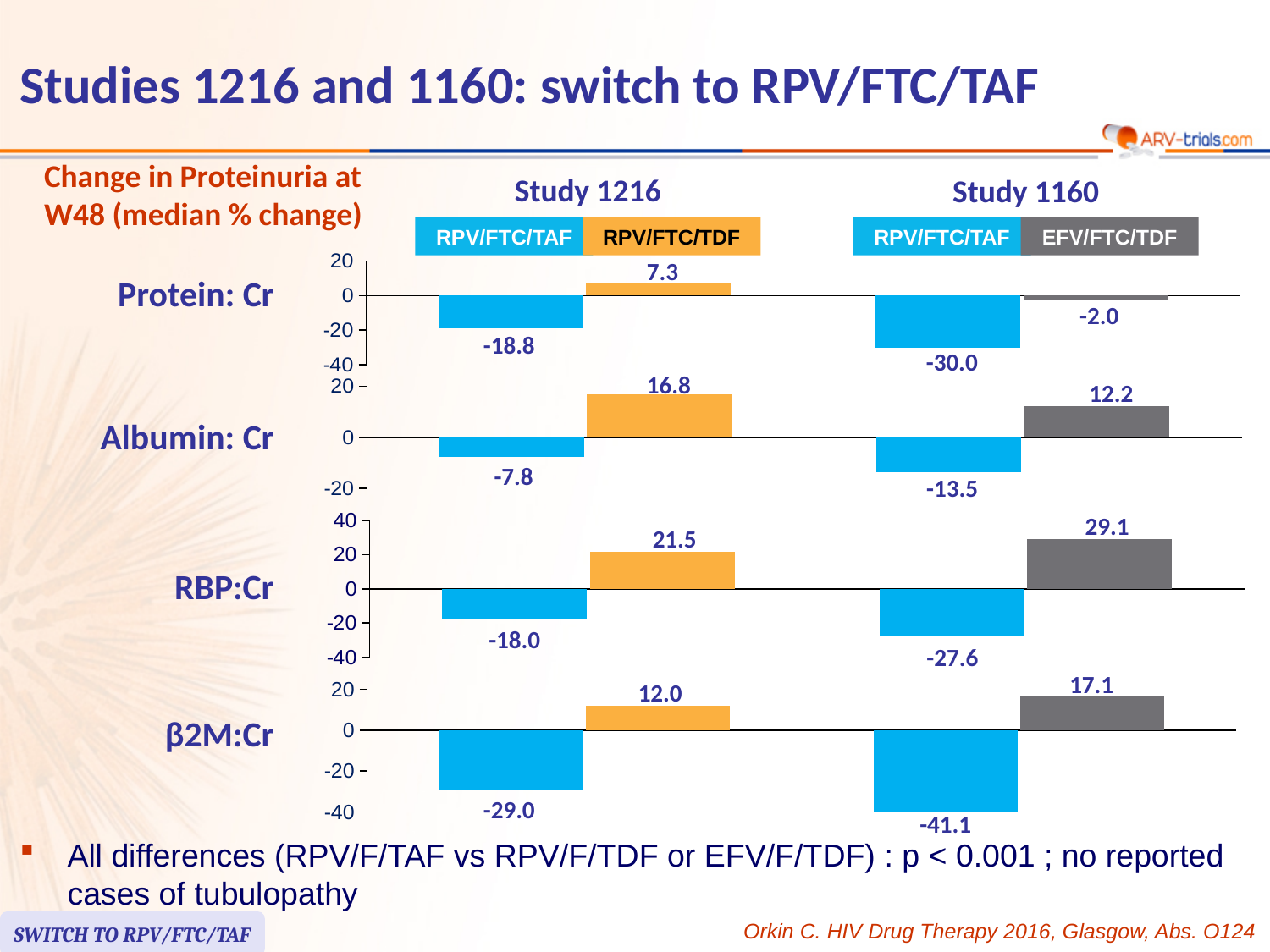
Which colour represents the RPV/FTC/TAF arm in the charts? Blue What type of chart is used to show the change in proteinuria on this slide? Bar chart In the RBP:Cr charts, which is larger: the RPV/FTC/TDF value in Study 1216 or the EFV/FTC/TDF value in Study 1160? EFV/FTC/TDF in Study 1160 (29.1) In the Protein: Cr chart for Study 1160, what is the median % change for EFV/FTC/TDF? -2.0 In the Albumin: Cr chart for Study 1216, what is the value for RPV/FTC/TDF? 16.8 Across all the charts, which arm and marker shows the lowest (most negative) median % change? RPV/FTC/TAF, β2M:Cr (Study 1160), -41.1 In the Protein: Cr chart for Study 1160, what is the difference between the EFV/FTC/TDF value (-2.0) and the RPV/FTC/TAF value (-30.0)? 28.0 In the β2M:Cr chart for Study 1160, what is the value for EFV/FTC/TDF? 17.1 In the β2M:Cr chart for Study 1216, what is the difference between the RPV/FTC/TDF value (12.0) and the RPV/FTC/TAF value (-29.0)? 41.0 How many proteinuria markers (chart rows) are shown on the slide? 4 In the Protein: Cr chart for Study 1216, what is the median % change for RPV/FTC/TAF? -18.8 In the RBP:Cr chart for Study 1160, what is the value for RPV/FTC/TAF? -27.6